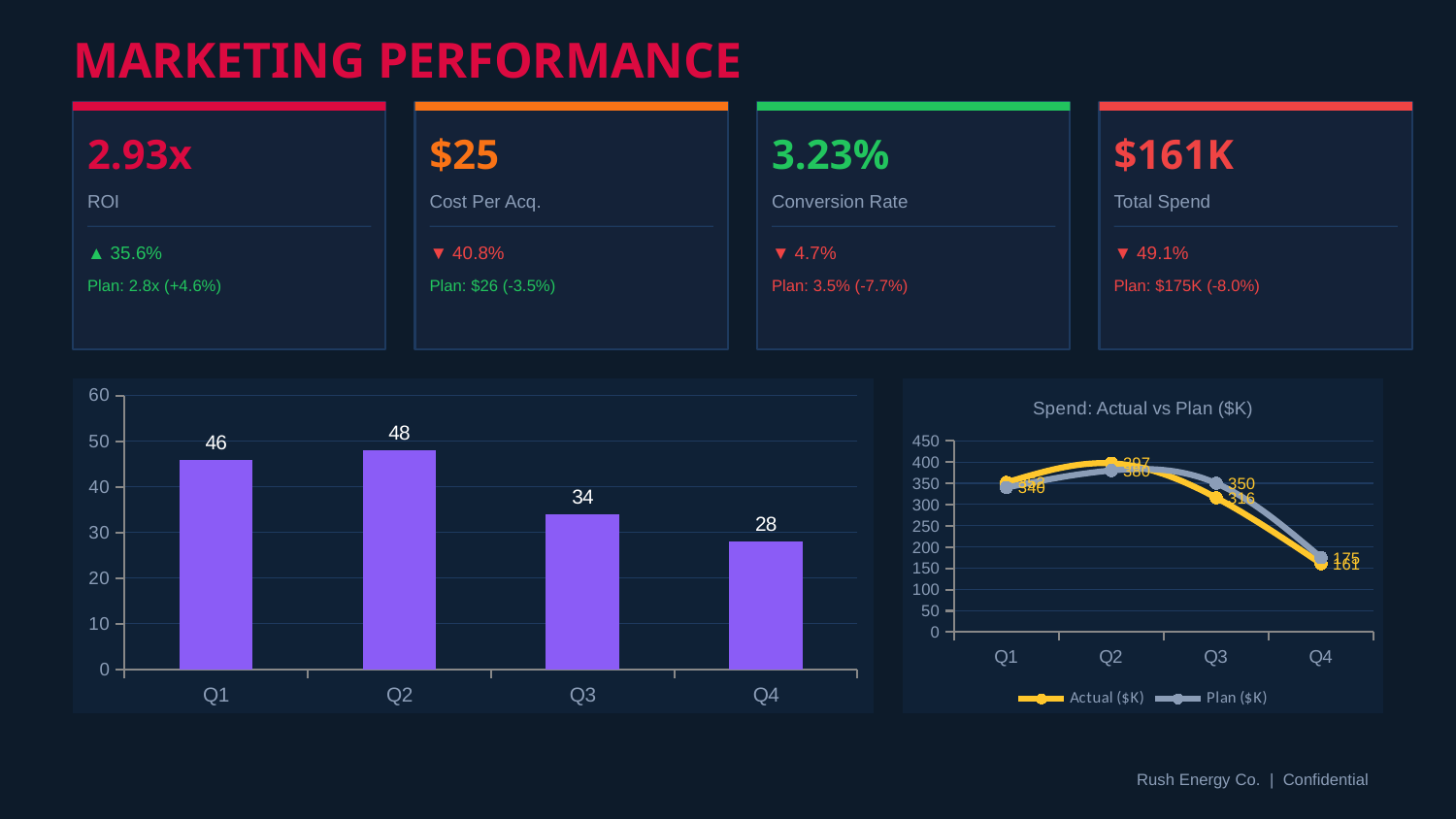
In the bar chart on the left, what is the value for Q3? 34 How many series does the legend of the 'Spend: Actual vs Plan ($K)' chart list? 2 In the bar chart on the left, what is the value for Q2? 48 In the bar chart on the left, what is the difference between the values for Q1 and Q4? 18 In the 'Spend: Actual vs Plan ($K)' chart, what is the Actual ($K) value for Q4? 161 How many quarters are shown in the bar chart on the left? 4 What kind of chart is the chart on the left of the slide? bar chart In the 'Spend: Actual vs Plan ($K)' chart, which series has the larger value in Q3, Actual ($K) or Plan ($K)? Plan ($K) In the bar chart on the left, which quarter has the highest value? Q2 In the bar chart on the left, which quarter has the lowest value? Q4 In the 'Spend: Actual vs Plan ($K)' chart, what is the Plan ($K) value for Q3? 350 In the bar chart on the left, do the values rise or fall from Q2 to Q4? fall